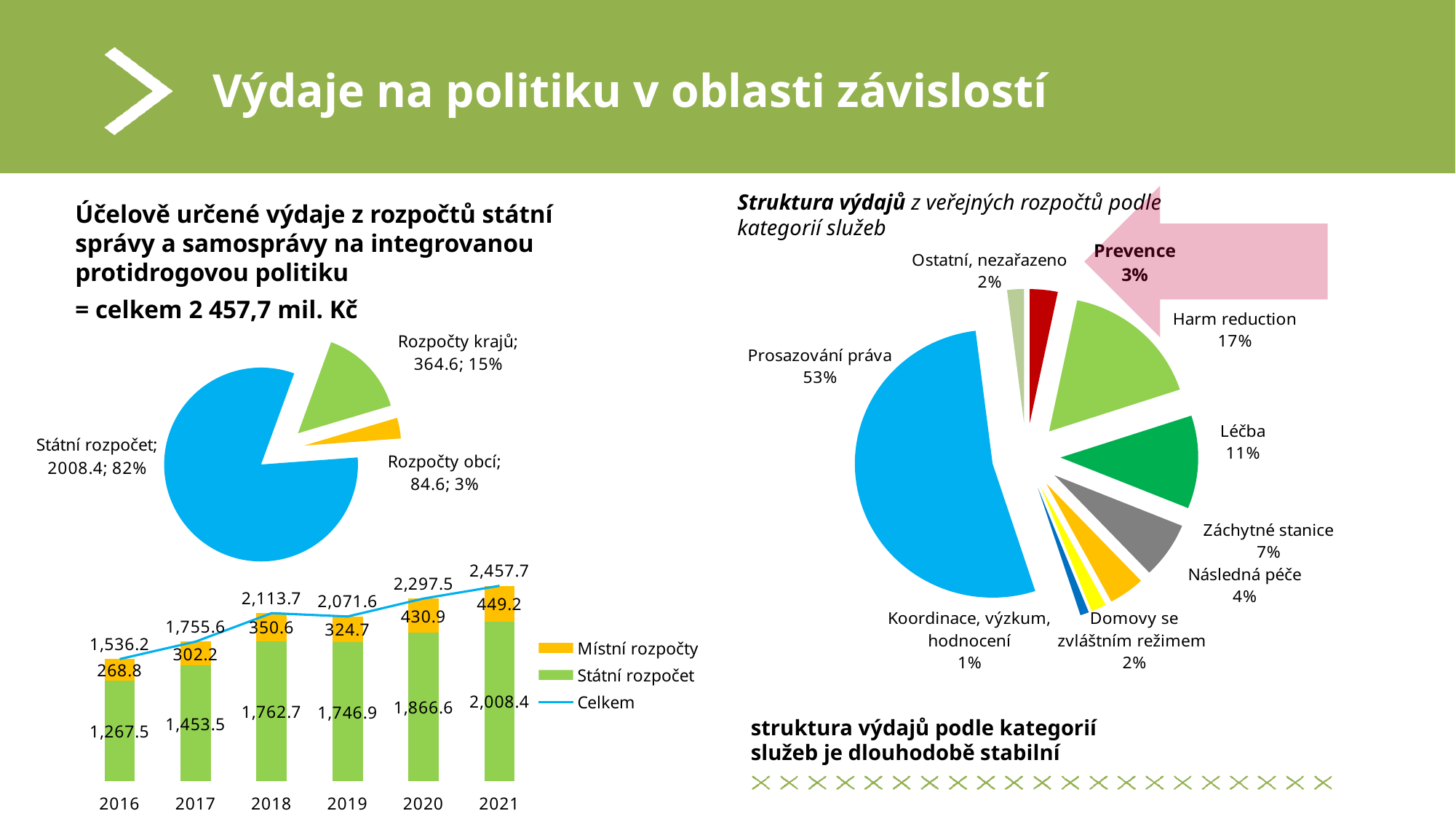
In the stacked bar chart at the bottom left, what is the Celkem value for 2018? 2,113.7 In the stacked bar chart at the bottom left, how many years are shown on the x axis? 6 In the stacked bar chart at the bottom left, which year has the highest Celkem value? 2021 In the left pie chart, what share does Rozpočty krajů have? 15% In the stacked bar chart at the bottom left, what is the Místní rozpočty value for 2021? 449.2 In the right pie chart (Struktura výdajů), what share does Harm reduction have? 17% In the left pie chart, what value and share are shown for Státní rozpočet? 2008.4; 82% In the right pie chart (Struktura výdajů), which category has the largest share? Prosazování práva In the stacked bar chart at the bottom left, how many series does the legend list? 3 In the left pie chart, which slice is the smallest? Rozpočty obcí In the stacked bar chart at the bottom left, what is the Státní rozpočet value for 2019? 1,746.9 In the stacked bar chart at the bottom left, what is the difference between the Celkem values for 2021 and 2020? 160.2